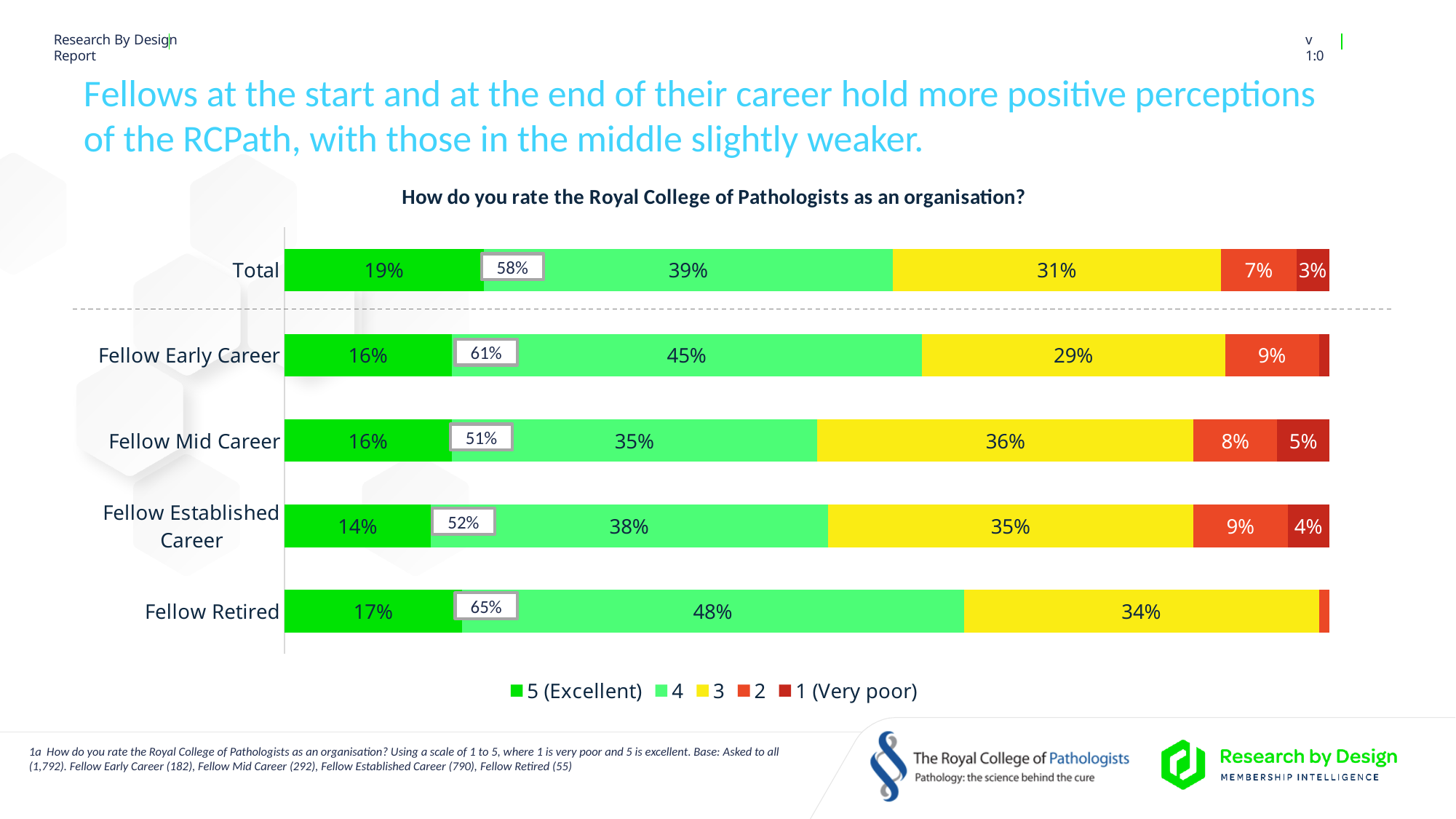
Which category has the highest percentage for the rating 4? Fellow Retired What percentage of Total respondents rated the RCPath 5 (Excellent)? 19% For Total, what is the difference between the percentage rating 4 and the percentage rating 3? 8% What percentage of Fellow Mid Career respondents gave a rating of 1 (Very poor)? 5% Which has a larger percentage for rating 3: Fellow Early Career or Fellow Mid Career? Fellow Mid Career What is the boxed combined value shown for Fellow Retired? 65% What percentage of Fellow Retired respondents gave a rating of 4? 48% How many series does the legend list? 5 Which category has the lowest percentage for the rating 5 (Excellent)? Fellow Established Career What percentage of Fellow Mid Career respondents gave a rating of 3? 36% What type of chart is shown on the slide? Stacked bar chart How many categories (bars) are shown in the chart? 5